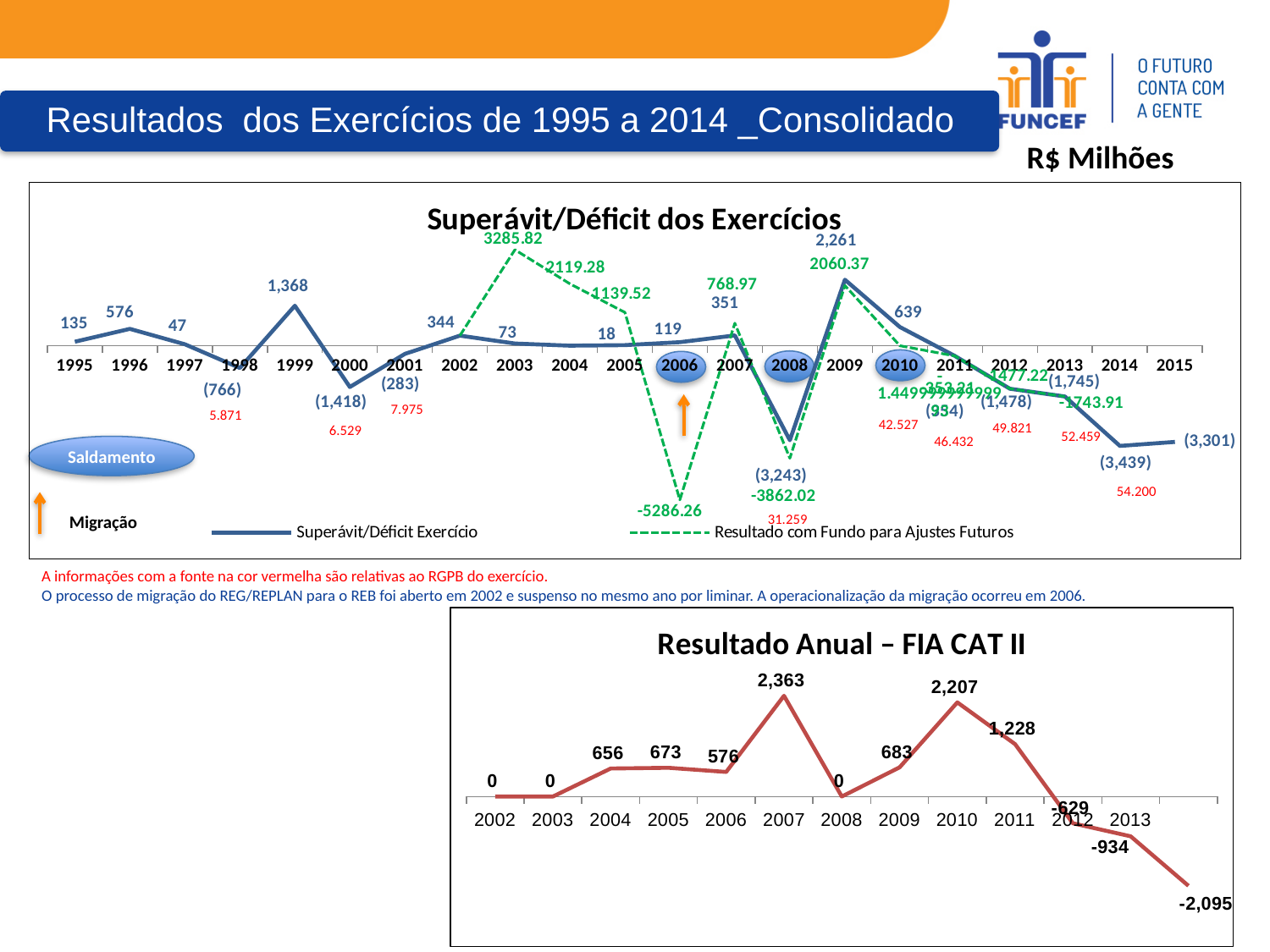
In the 'Resultado Anual – FIA CAT II' chart, what is the value for 2010? 2,207 In the 'Resultado Anual – FIA CAT II' chart, do the values rise or fall from 2011 to 2013? fall In the 'Superávit/Déficit dos Exercícios' chart, what is the value of the Superávit/Déficit Exercício series for 1999? 1,368 How many series does the legend of the 'Superávit/Déficit dos Exercícios' chart list? 2 In the 'Resultado Anual – FIA CAT II' chart, which is larger, the value for 2005 or the value for 2006? 2005 In the 'Resultado Anual – FIA CAT II' chart, which year has the highest value? 2007 In the 'Resultado Anual – FIA CAT II' chart, what is the value for 2013? -934 In the 'Resultado Anual – FIA CAT II' chart, what is the difference between the values for 2007 and 2010? 156 In the 'Resultado Anual – FIA CAT II' chart, what is the lowest value plotted? -2,095 What kind of chart is 'Superávit/Déficit dos Exercícios'? line chart In the 'Resultado Anual – FIA CAT II' chart, what is the value for 2007? 2,363 In the 'Superávit/Déficit dos Exercícios' chart, what is the highest value shown for the dashed 'Resultado com Fundo para Ajustes Futuros' series? 3285.82